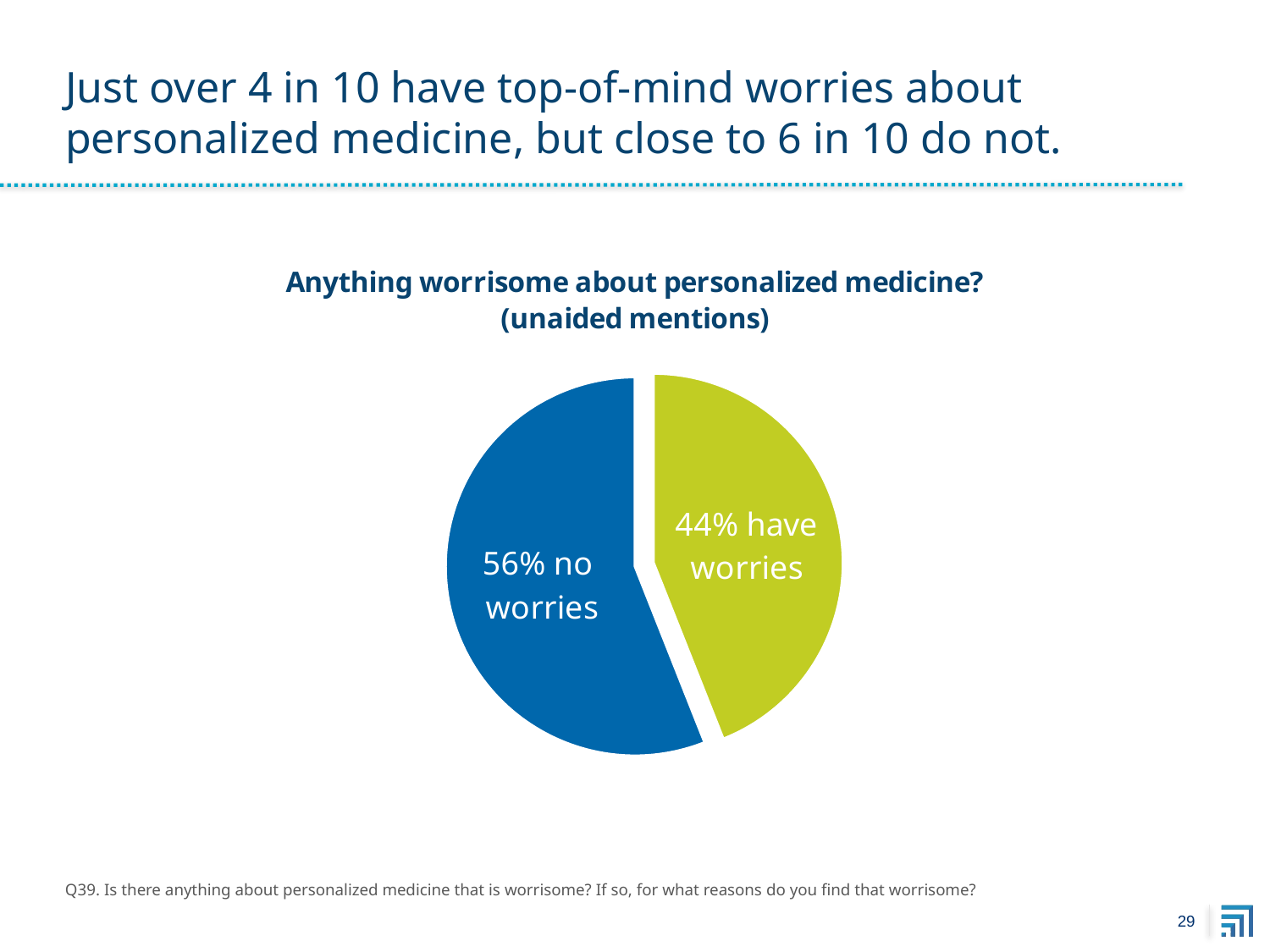
What share of the pie does the 'have worries' slice represent? 44% Which category has the largest share of the pie? no worries What percentage of respondents have no worries about personalized medicine? 56% What colour is the 'have worries' slice of the pie? green What percentage of respondents have worries about personalized medicine? 44% What kind of chart is shown on the slide? pie chart What is the difference in percentage points between the 'no worries' and 'have worries' slices? 12 Which category has the smallest share of the pie? have worries Which slice of the pie is larger: 'no worries' or 'have worries'? no worries How many slices does the pie chart have? 2 What is the title of the pie chart? Anything worrisome about personalized medicine? (unaided mentions)